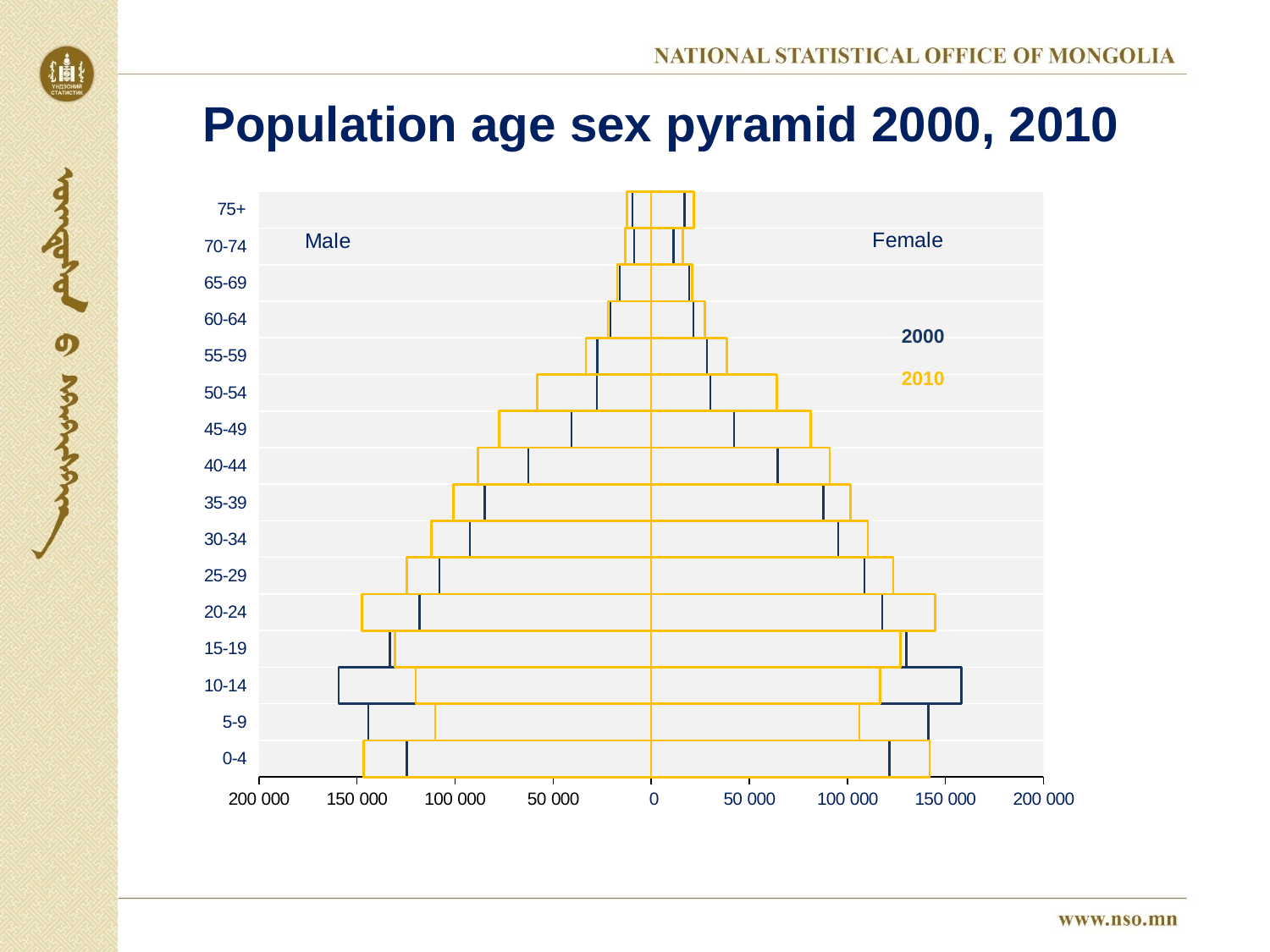
How many years does the chart's legend list? 2 What kind of chart is shown on the slide? Bar chart (population pyramid) Is the male population aged 55-59 in 2010 greater or less than 50 000? less For the 20-24 age group, was the female population larger in 2000 or in 2010? 2010 In 2000, which age group has the largest male population? 10-14 Is the male population aged 10-14 in 2000 greater or less than 150 000? greater What is the title of the chart on the slide? Population age sex pyramid 2000, 2010 For the 10-14 age group, was the male population larger in 2000 or in 2010? 2000 Is the male population aged 20-24 in 2010 greater or less than 100 000? greater How many age groups are shown on the vertical axis of the chart? 16 Which colour represents the year 2010 in the chart? Yellow